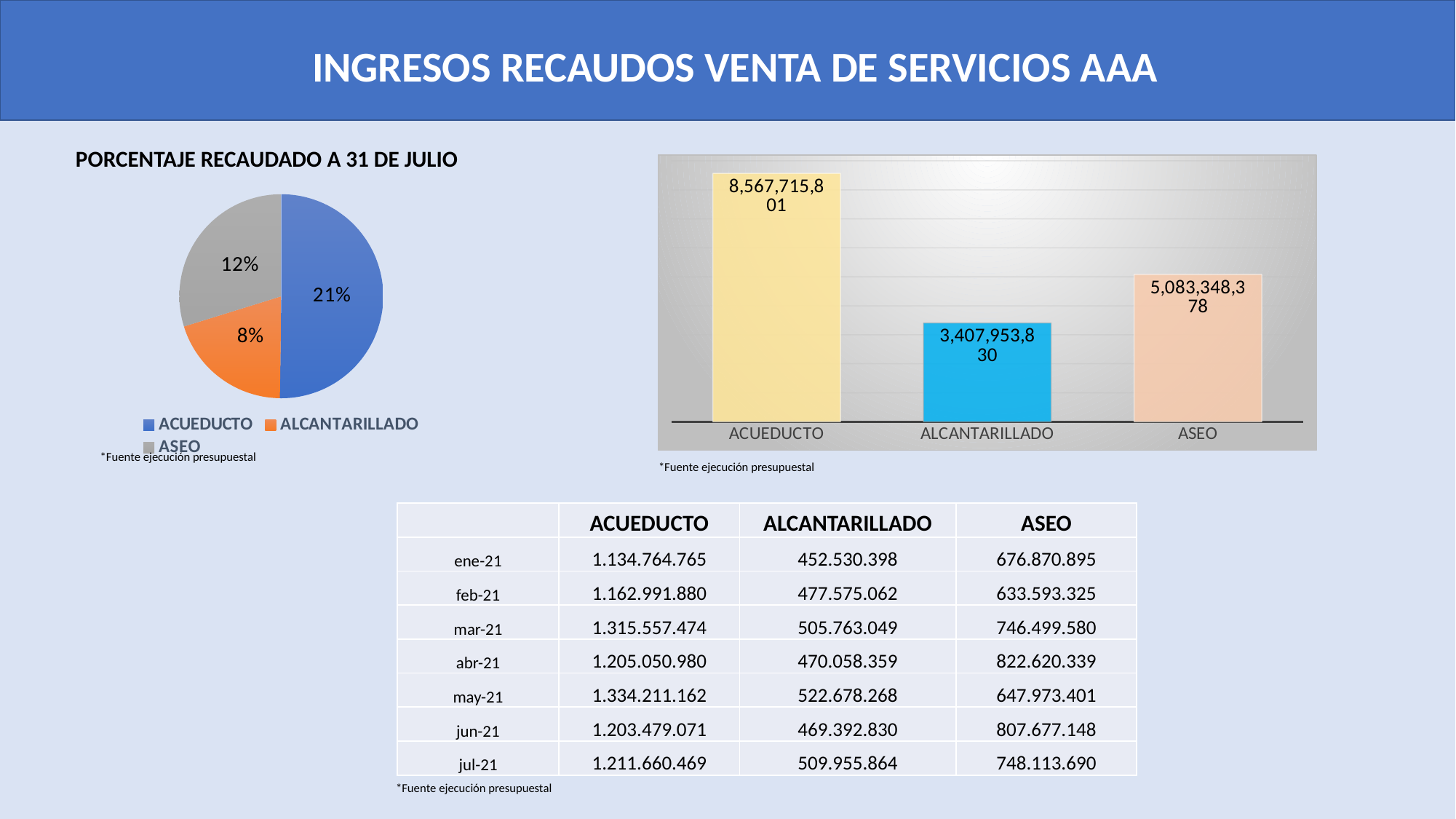
What kind of chart is shown on the right of the slide? Bar chart In the pie chart titled PORCENTAJE RECAUDADO A 31 DE JULIO, what percentage is shown for ACUEDUCTO? 21% In the bar chart on the right of the slide, what is the value for ALCANTARILLADO? 3,407,953,830 In the bar chart on the right of the slide, what is the value for ACUEDUCTO? 8,567,715,801 In the pie chart titled PORCENTAJE RECAUDADO A 31 DE JULIO, which category has the largest slice? ACUEDUCTO In the bar chart on the right of the slide, what is the difference between the values for ACUEDUCTO and ALCANTARILLADO? 5,159,761,971 In the pie chart titled PORCENTAJE RECAUDADO A 31 DE JULIO, which category has the smallest slice? ALCANTARILLADO In the pie chart titled PORCENTAJE RECAUDADO A 31 DE JULIO, what percentage is shown for ALCANTARILLADO? 8% In the bar chart on the right of the slide, which category has the lowest value? ALCANTARILLADO In the bar chart on the right of the slide, what is the value for ASEO? 5,083,348,378 In the pie chart titled PORCENTAJE RECAUDADO A 31 DE JULIO, how many entries does the legend list? 3 In the pie chart titled PORCENTAJE RECAUDADO A 31 DE JULIO, what percentage is shown for ASEO? 12%